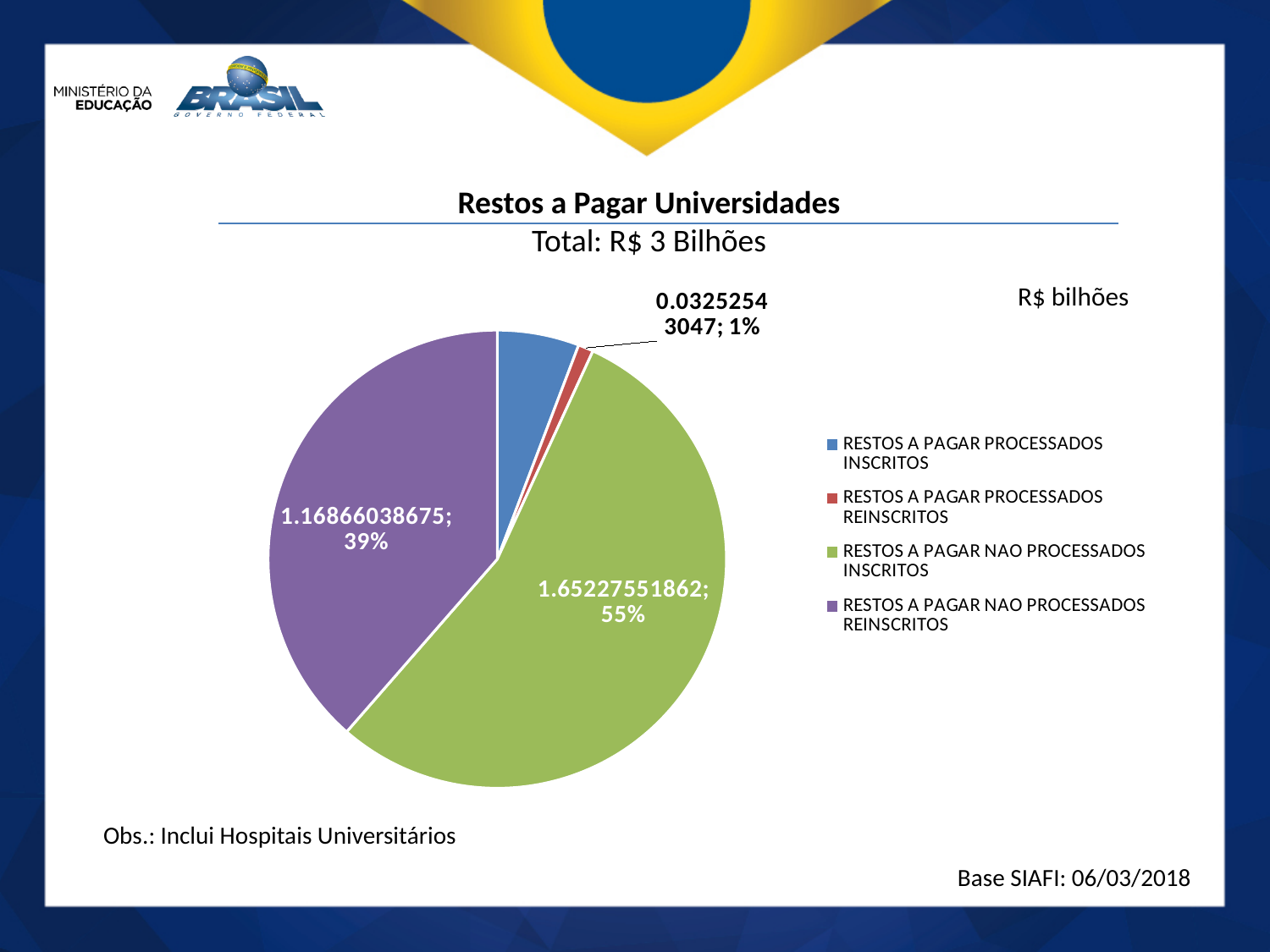
What value is labelled for RESTOS A PAGAR NAO PROCESSADOS REINSCRITOS? 1.16866038675 How many slices does the pie chart have? 4 What is the title of the chart? Restos a Pagar Universidades How many entries does the legend list? 4 Which is larger, the slice for RESTOS A PAGAR NAO PROCESSADOS INSCRITOS or the slice for RESTOS A PAGAR NAO PROCESSADOS REINSCRITOS? RESTOS A PAGAR NAO PROCESSADOS INSCRITOS What unit is indicated for the values in the chart? R$ bilhões What kind of chart is shown on the slide? pie chart Which category has the smallest slice of the pie? RESTOS A PAGAR PROCESSADOS REINSCRITOS Which category has the largest slice of the pie? RESTOS A PAGAR NAO PROCESSADOS INSCRITOS What share of the pie does RESTOS A PAGAR NAO PROCESSADOS INSCRITOS represent? 55% What share of the pie does RESTOS A PAGAR NAO PROCESSADOS REINSCRITOS represent? 39% What value is labelled for RESTOS A PAGAR NAO PROCESSADOS INSCRITOS? 1.65227551862